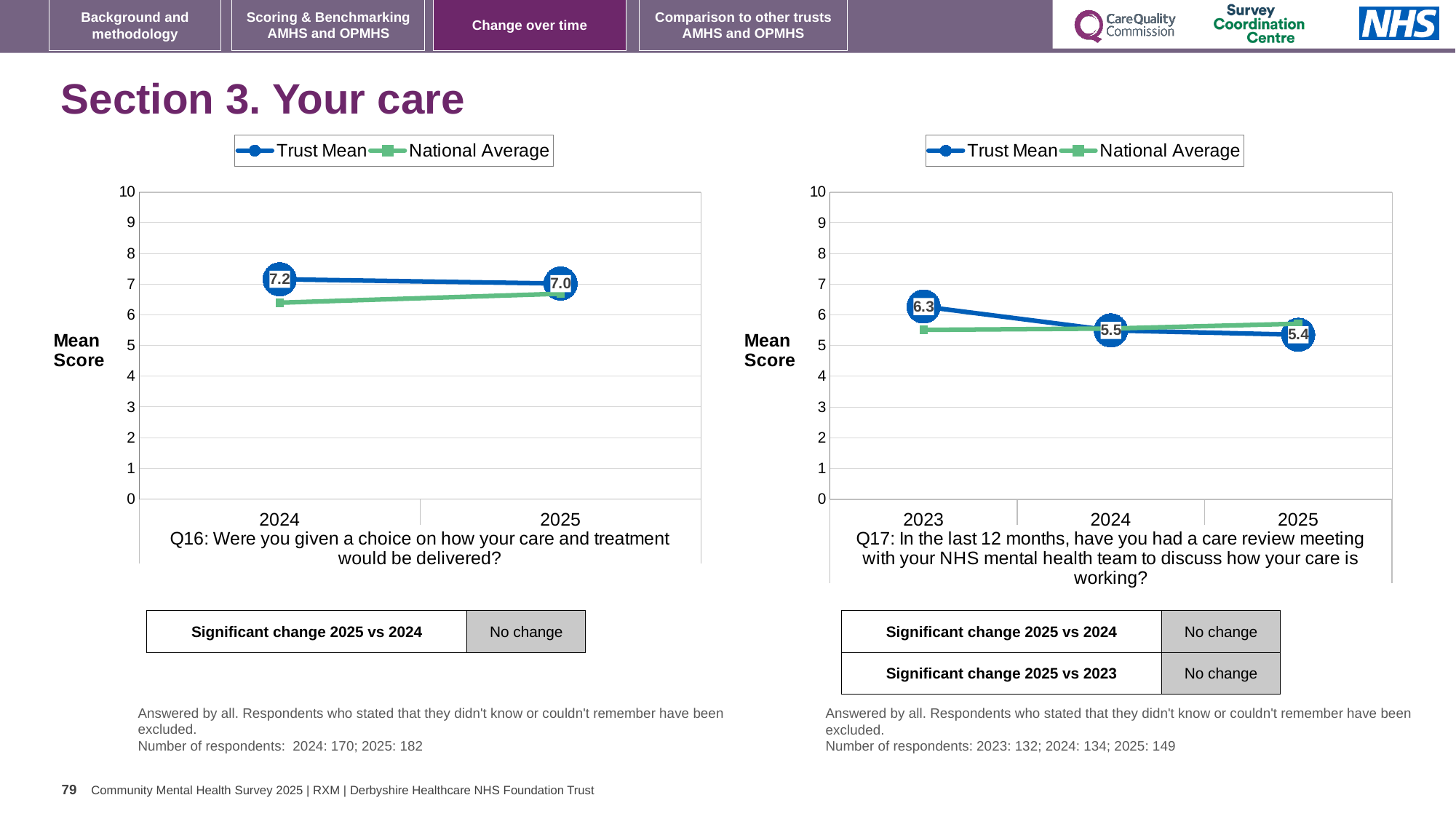
In the right chart (Q17), what is the Trust Mean for 2025? 5.4 In the left chart (Q16), is the National Average for 2024 greater or less than 7? less In the left chart (Q16), what is the Trust Mean for 2025? 7.0 In the right chart (Q17), what is the difference between the Trust Mean for 2023 and 2025? 0.9 How many series does the legend of the left chart (Q16) list? 2 In the right chart (Q17), does the Trust Mean rise or fall from 2023 to 2025? fall In the left chart (Q16), is the Trust Mean higher in 2024 or 2025? 2024 In the right chart (Q17), what is the Trust Mean for 2023? 6.3 In the right chart (Q17), which year has the highest Trust Mean? 2023 In the left chart (Q16), what is the difference between the Trust Mean for 2024 and 2025? 0.2 How many years are plotted on the x axis of the right chart (Q17)? 3 In the left chart (Q16), what is the Trust Mean for 2024? 7.2